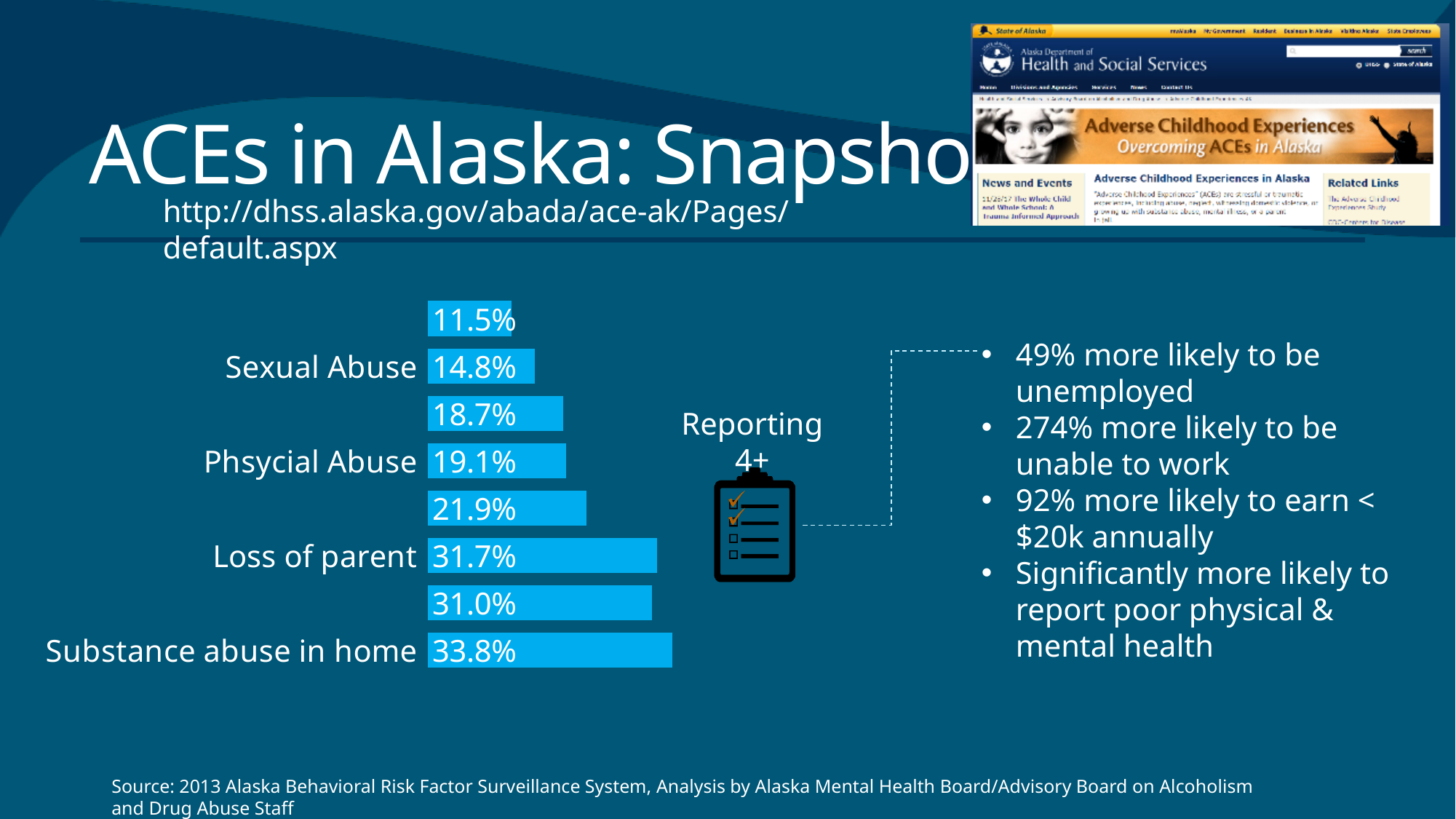
Which labelled category has the lowest value? Sexual Abuse What kind of chart is shown on the slide? bar chart Which is larger, the value for Loss of parent or the value for Substance abuse in home? Substance abuse in home What is the value of the bar labelled Loss of parent? 31.7% What is the value of the bar labelled Substance abuse in home? 33.8% What is the value of the bar labelled Sexual Abuse? 14.8% How many bars are plotted in the chart? 8 What is the difference between the Substance abuse in home value and the Physical Abuse value? 14.7 percentage points What is the smallest value shown on any bar in the chart? 11.5% Which labelled category has the highest value? Substance abuse in home What is the value of the bar labelled Physical Abuse? 19.1% What is the difference between the Loss of parent value and the Sexual Abuse value? 16.9 percentage points